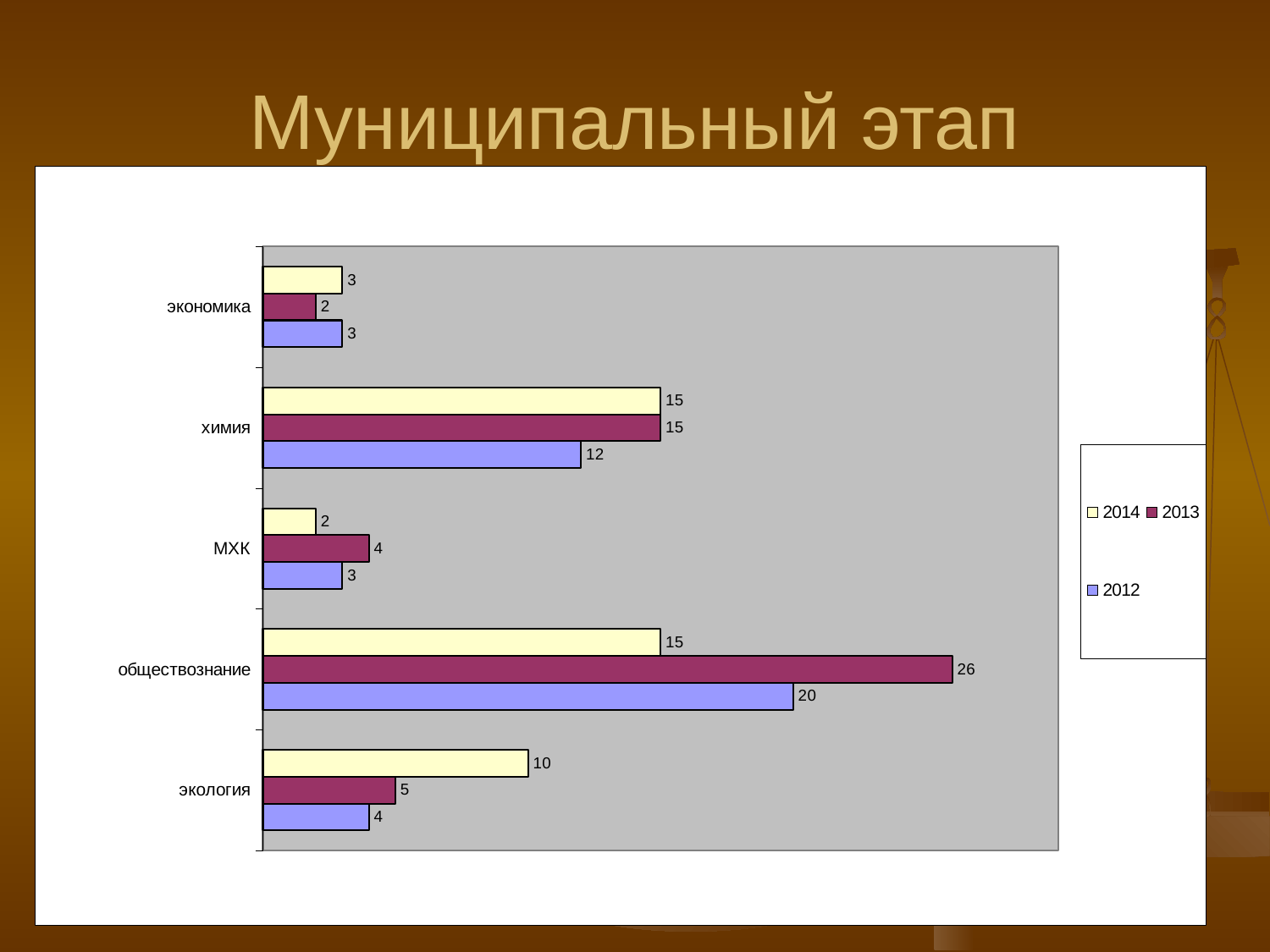
What is the title of the slide containing the chart? Муниципальный этап Which category has the lowest value in the 2014 series? МХК What is the value for экология in the 2014 series? 10 Which category has the highest value in the 2012 series? обществознание Which is larger for экология: the 2013 value or the 2012 value? 2013 What type of chart is shown on the slide? bar chart How many categories are shown on the chart? 5 What is the difference between the 2014 and 2013 values for экология? 5 What is the difference between the 2013 and 2014 values for обществознание? 11 What is the value for обществознание in the 2013 series? 26 How many series does the legend list? 3 What is the value for химия in the 2012 series? 12